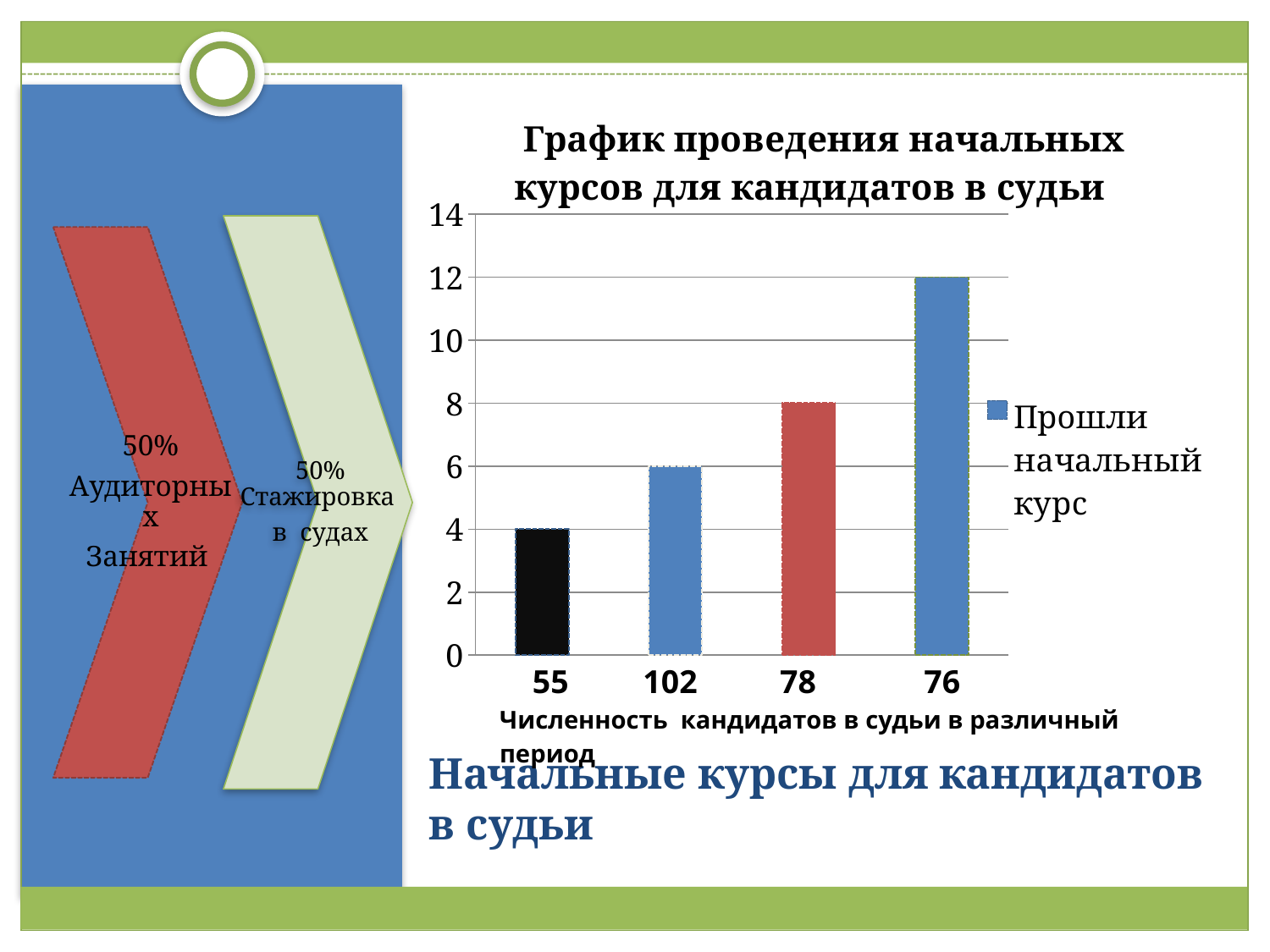
Which category has the highest bar? 76 Which category has the lowest bar? 55 Do the bar values rise or fall from left to right along the x axis? rise How many categories are shown on the x axis of the chart? 4 What is the value of the bar for category 76? 12 What is the title of the chart? График проведения начальных курсов для кандидатов в судьи What is the value of the bar for category 102? 6 What is the value of the bar for category 55? 4 How many series does the chart legend list? 1 What type of chart is shown on the slide? bar chart What is the value of the bar for category 78? 8 Which is larger, the bar for 102 or the bar for 78? 78